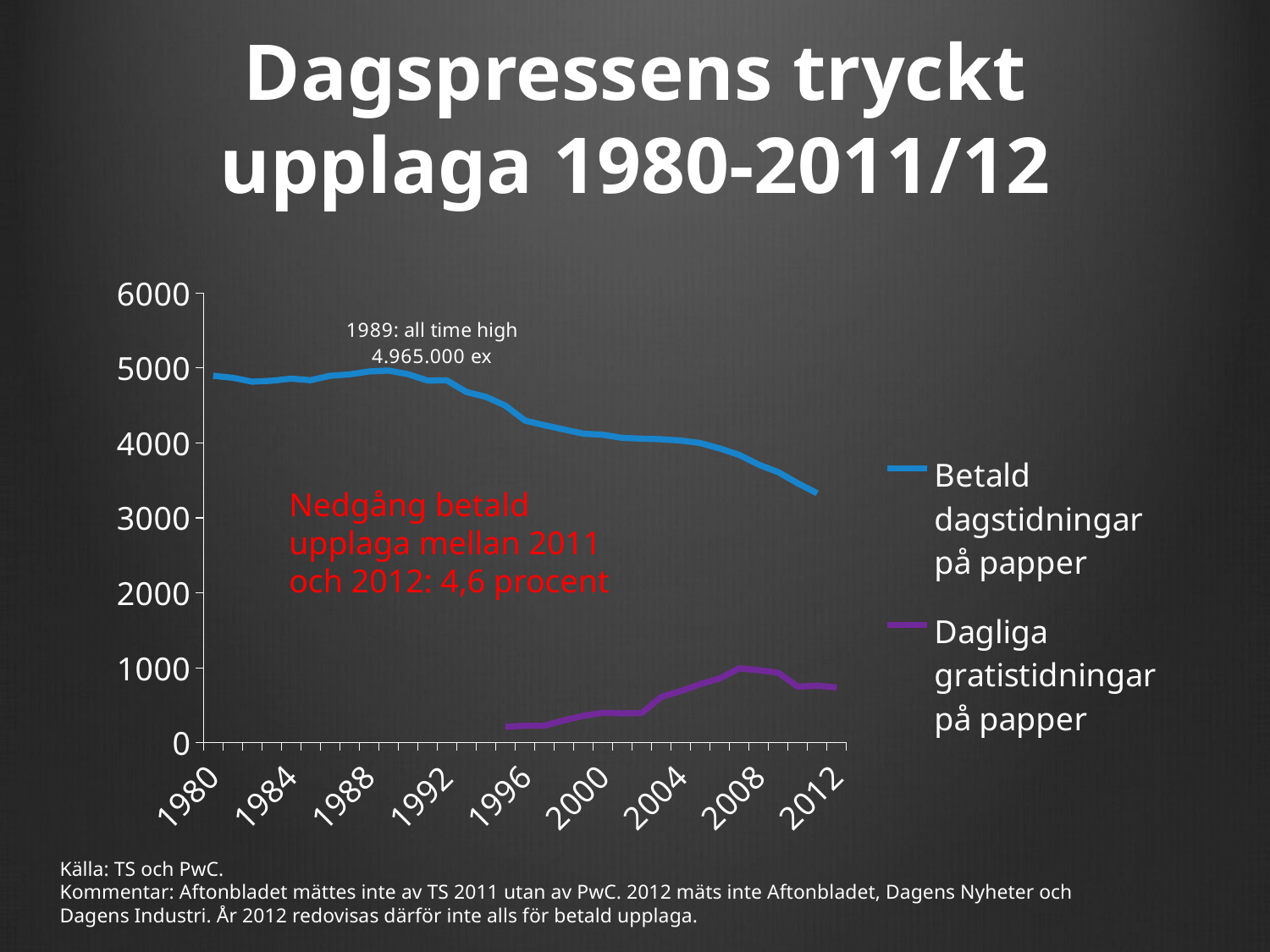
In which year does the annotation say the paid daily newspaper circulation reached its all-time high? 1989 Which series is drawn in blue? Betald dagstidningar på papper Which series has the larger value in 2008, Betald dagstidningar på papper or Dagliga gratistidningar på papper? Betald dagstidningar på papper Does the value for Betald dagstidningar på papper rise or fall from 1989 to 2011? fall According to the annotation, what was the all-time high circulation in 1989? 4.965.000 ex What is the title of the chart on the slide? Dagspressens tryckt upplaga 1980-2011/12 What kind of chart is shown on the slide? line chart Is the value for Betald dagstidningar på papper in 2011 greater or less than 4000? less How many series does the legend list? 2 Which year has the larger value for Betald dagstidningar på papper, 1980 or 2011? 1980 Is the value for Betald dagstidningar på papper in 1980 greater or less than 4000? greater Is the value for Dagliga gratistidningar på papper in 1996 greater or less than 1000? less